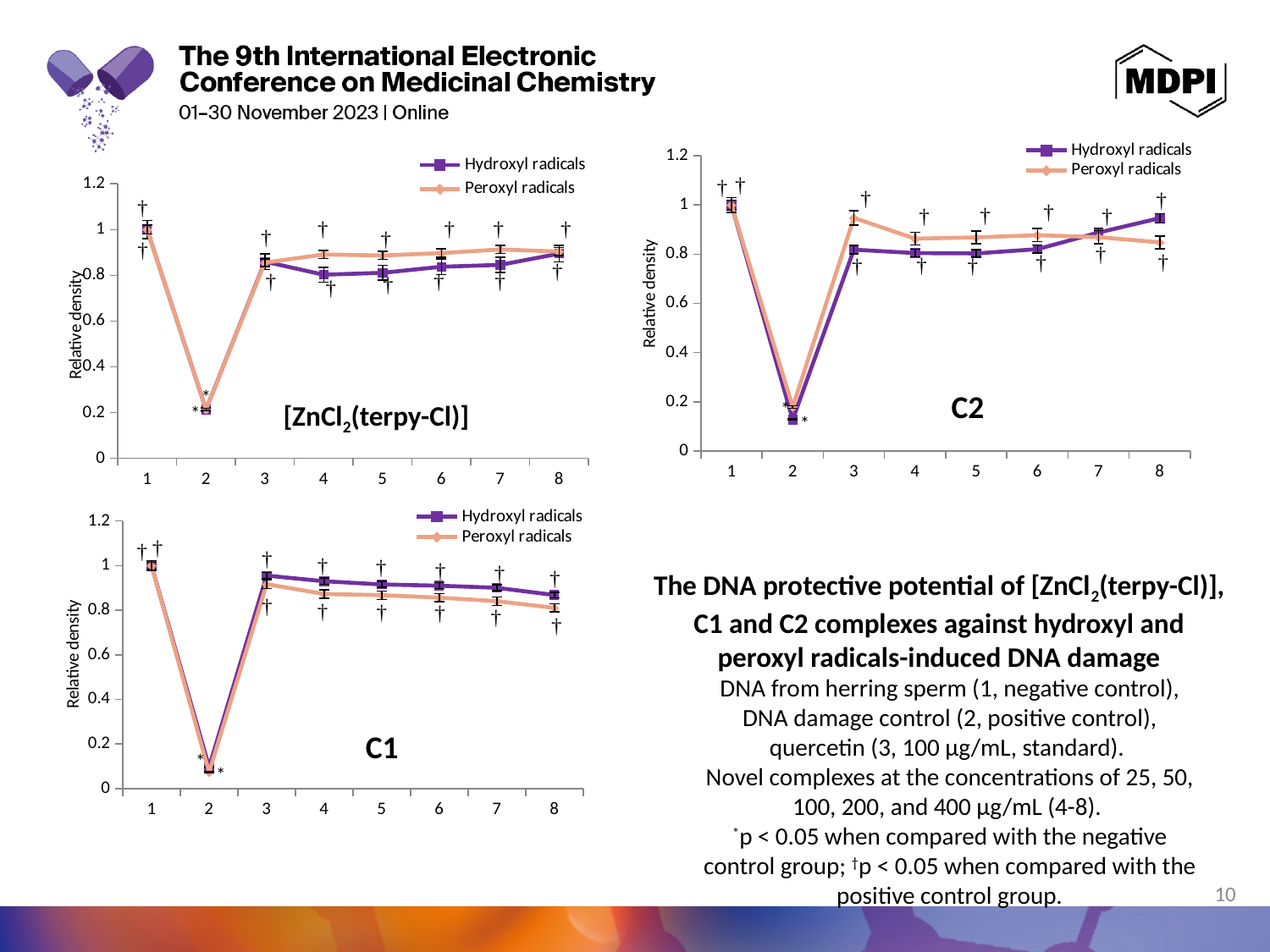
In the C2 chart, is the Hydroxyl radicals value at category 2 greater or less than 0.4? less In the C1 chart, is the Peroxyl radicals value at category 2 greater or less than 0.2? less How many points are plotted along the x axis of the C2 chart for each series? 8 What kind of chart is the [ZnCl2(terpy-Cl)] chart? line chart What is the y-axis title of the C2 chart? Relative density In the C2 chart, at category 3, which series has the larger value, Hydroxyl radicals or Peroxyl radicals? Peroxyl radicals In the [ZnCl2(terpy-Cl)] chart, is the Hydroxyl radicals value at category 1 greater or less than 0.8? greater In the [ZnCl2(terpy-Cl)] chart, which x-axis category has the highest value for Peroxyl radicals? 1 In the C1 chart, which x-axis category has the lowest value for Hydroxyl radicals? 2 In the [ZnCl2(terpy-Cl)] chart, at category 4, which series has the larger value, Hydroxyl radicals or Peroxyl radicals? Peroxyl radicals In the C1 chart, do the Hydroxyl radicals values rise or fall from category 1 to category 2? fall How many series does the legend of the C1 chart list? 2